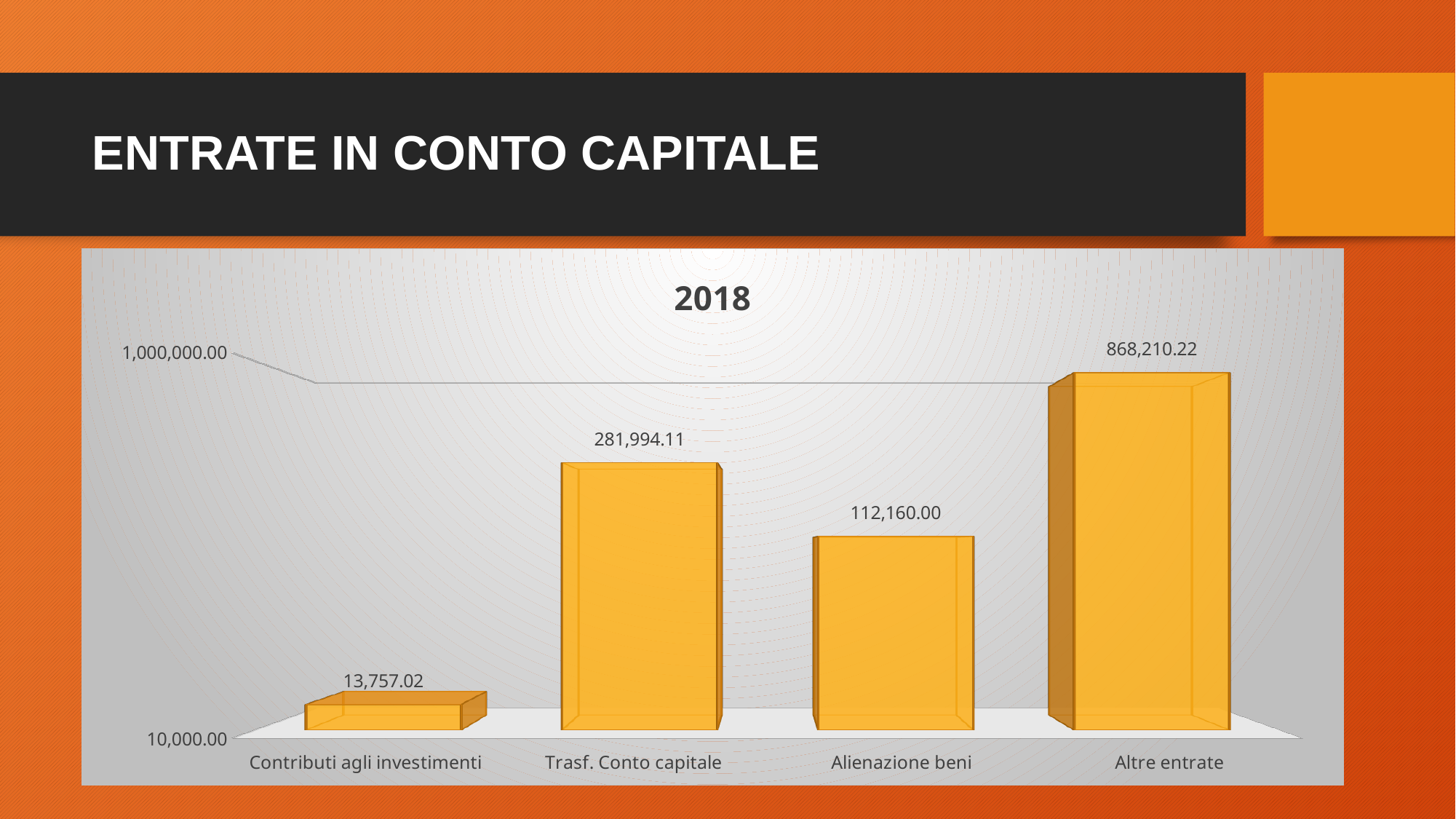
How many categories are shown in the chart? 4 Is the value for Altre entrate greater or less than 1,000,000.00? less What is the value for Altre entrate? 868,210.22 What is the difference between the values for Trasf. Conto capitale and Alienazione beni? 169,834.11 Which is larger, the value for Alienazione beni or the value for Trasf. Conto capitale? Trasf. Conto capitale What is the value for Contributi agli investimenti? 13,757.02 What is the title of the chart? 2018 Which category has the lowest value? Contributi agli investimenti What is the difference between the values for Altre entrate and Trasf. Conto capitale? 586,216.11 What is the value for Trasf. Conto capitale? 281,994.11 Which category has the highest value? Altre entrate What is the value for Alienazione beni? 112,160.00